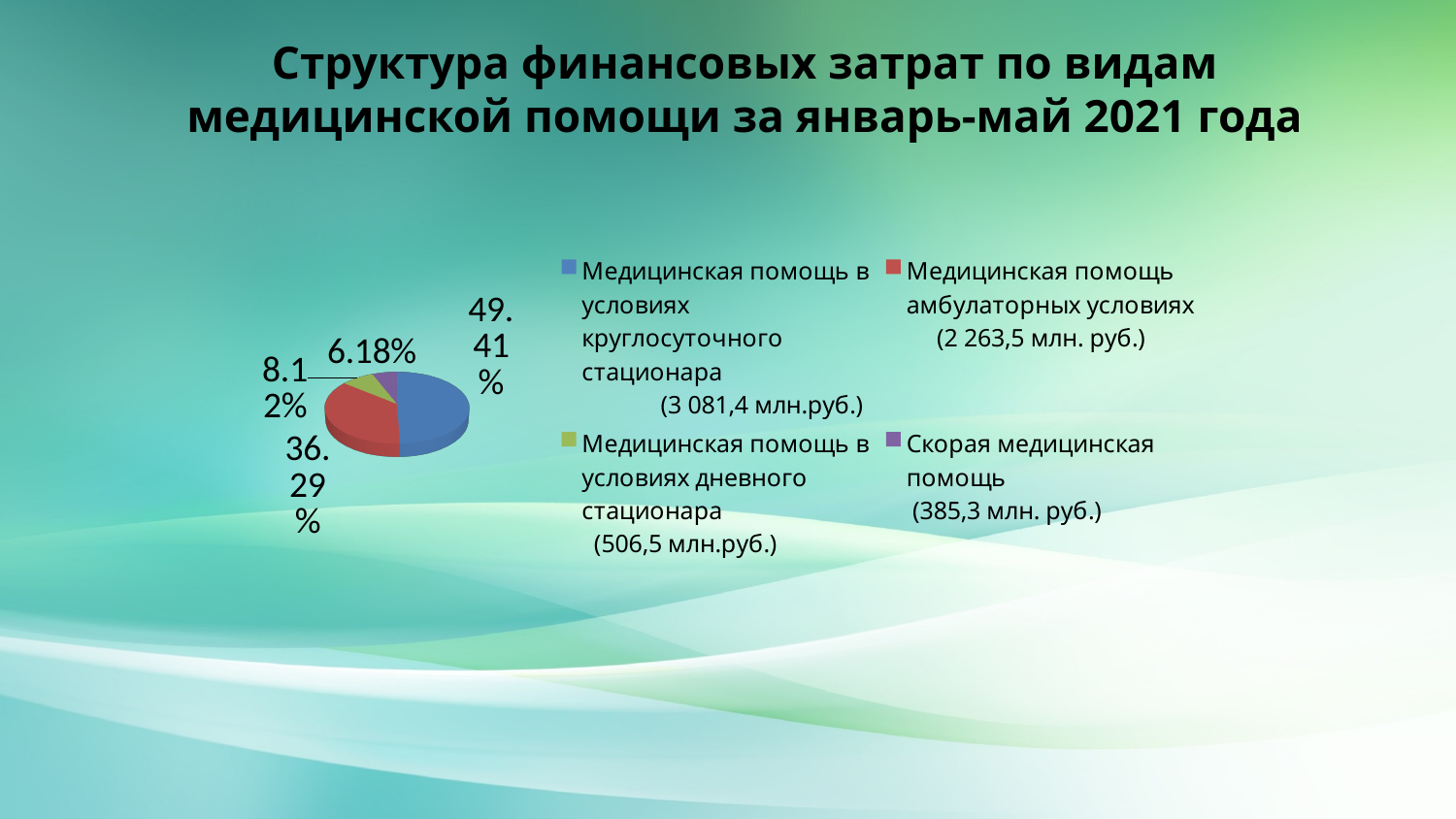
Which category has the largest share of the pie? Медицинская помощь в условиях круглосуточного стационара What share of the pie does 'Медицинская помощь амбулаторных условиях' have? 36.29% Which category has the smallest share of the pie? Скорая медицинская помощь How many entries does the legend of the pie chart list? 4 How many slices does the pie chart have? 4 What kind of chart is shown on the slide? pie chart What share of the pie does 'Медицинская помощь в условиях дневного стационара' have? 8.12% What is the difference in percentage points between the shares of 'Медицинская помощь в условиях круглосуточного стационара' and 'Медицинская помощь амбулаторных условиях'? 13.12 What colour is the slice for 'Скорая медицинская помощь'? purple Which has the larger share: 'Медицинская помощь в условиях дневного стационара' or 'Скорая медицинская помощь'? Медицинская помощь в условиях дневного стационара What share of the pie does 'Скорая медицинская помощь' have? 6.18%